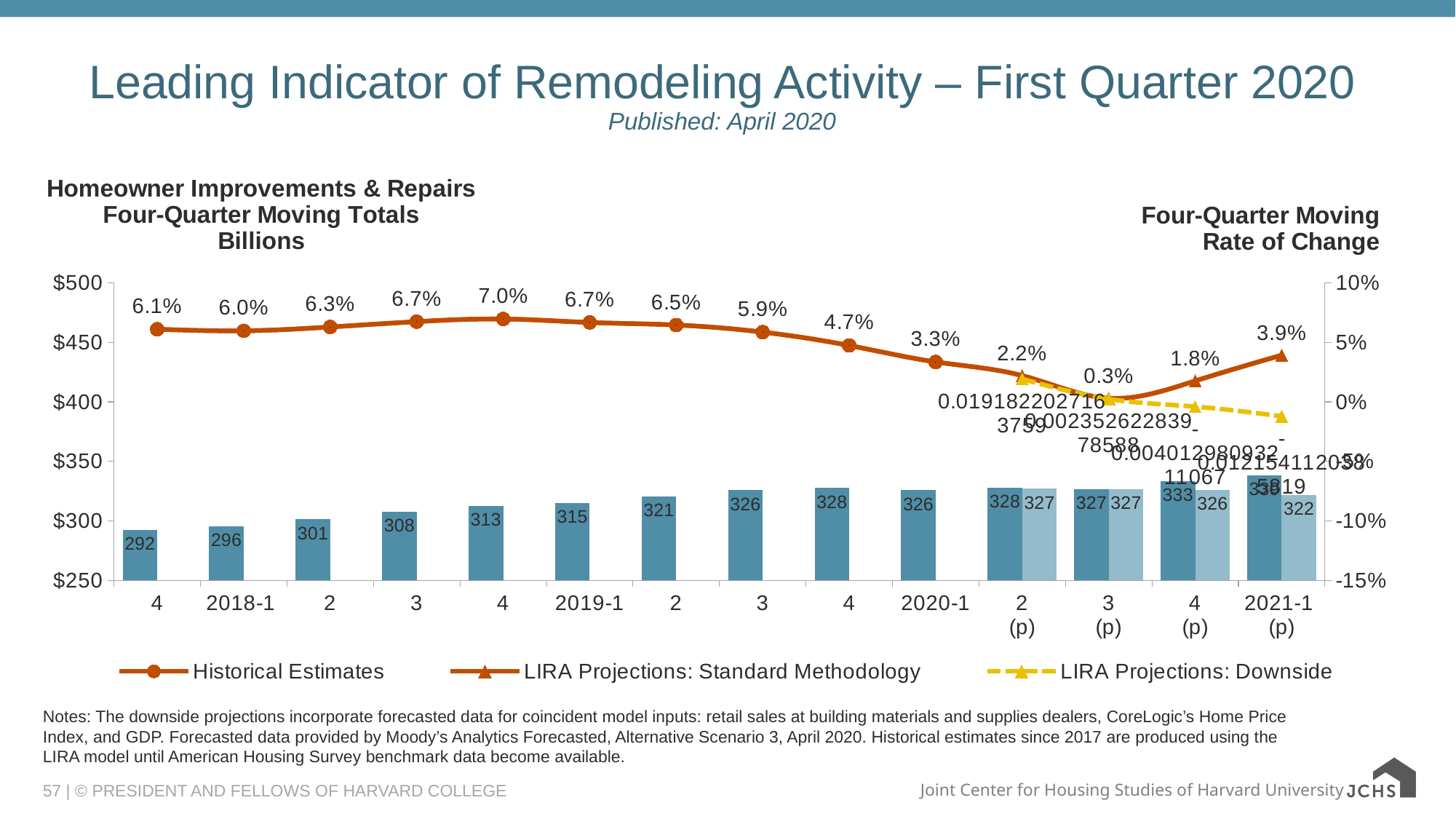
How many series does the legend list? 3 What is the four-quarter moving total (billions) shown for 2019-1? 315 What four-quarter moving rate of change does the Historical Estimates line show for the fourth quarter of 2019 (the '4' before 2020-1)? 4.7% What is the lowest four-quarter moving total labeled on the bars? 292 What rate of change does the LIRA Projections: Standard Methodology line show for 2021-1 (p)? 3.9% Is the Historical Estimates rate of change for 2020-1 greater or less than 5%? less By how many percentage points does the Standard Methodology projection for 2 (p) exceed the projection for 3 (p)? 1.9 percentage points Which has the larger four-quarter moving total: 2019-3 or the following quarter 4? 4 (Q4 2019), 328 How many quarters are shown along the x axis? 14 What kind of chart is this? Combination bar and line chart How much larger is the four-quarter moving total for 2020-1 than for 2018-1? 30 What is the highest rate of change value labeled on the Historical Estimates line? 7.0%